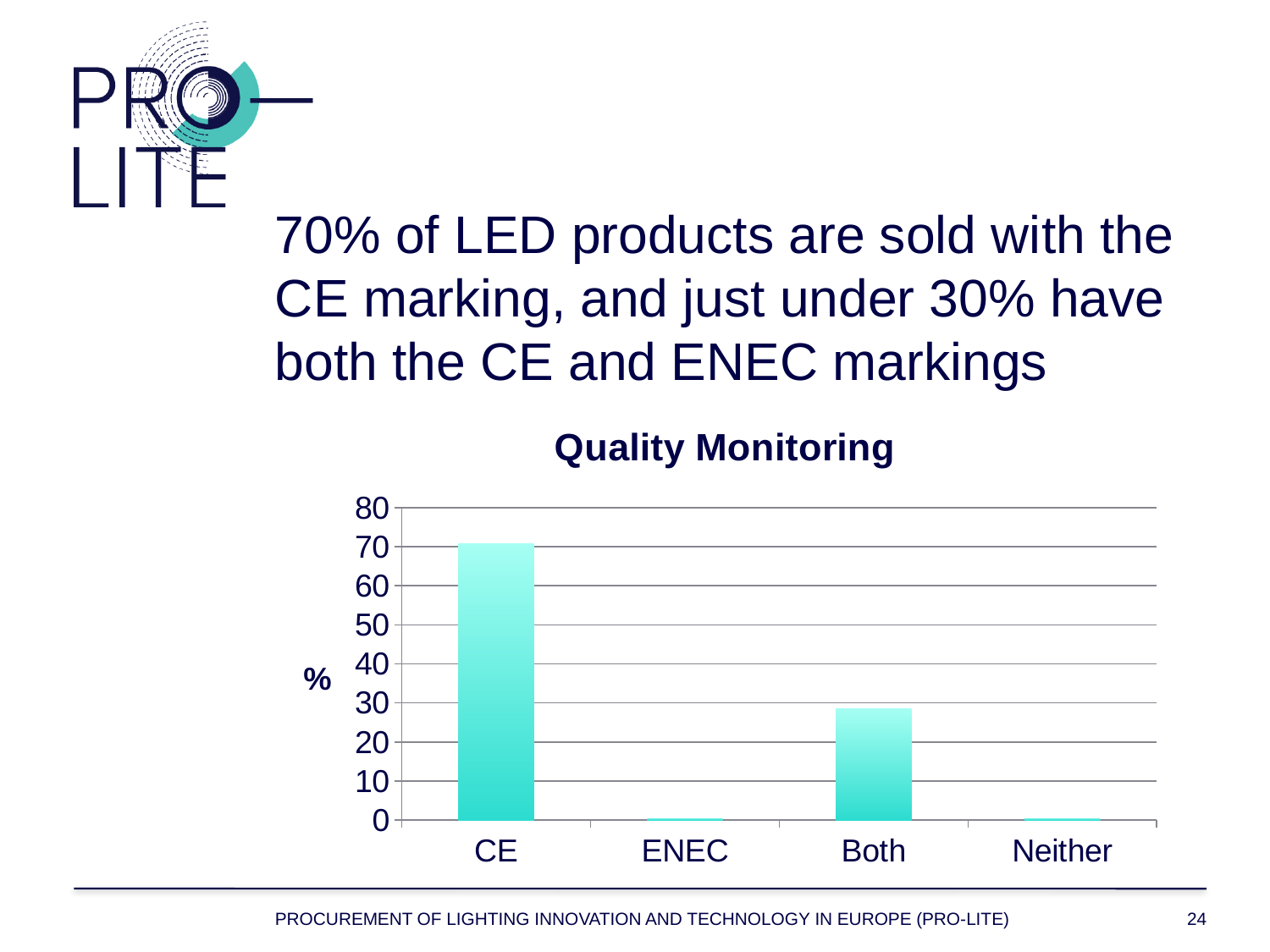
Which is larger, the value for CE or the value for Both? CE What is the label on the vertical axis of the chart? % Is the value for CE greater or less than 60? greater How many categories are shown on the x axis of the chart? 4 Is the value for Neither greater or less than 10? less What type of chart is shown on the slide? bar chart What is the title of the chart? Quality Monitoring Which is larger, the value for Both or the value for ENEC? Both Is the value for ENEC greater or less than 10? less Which category has the highest value in the chart? CE